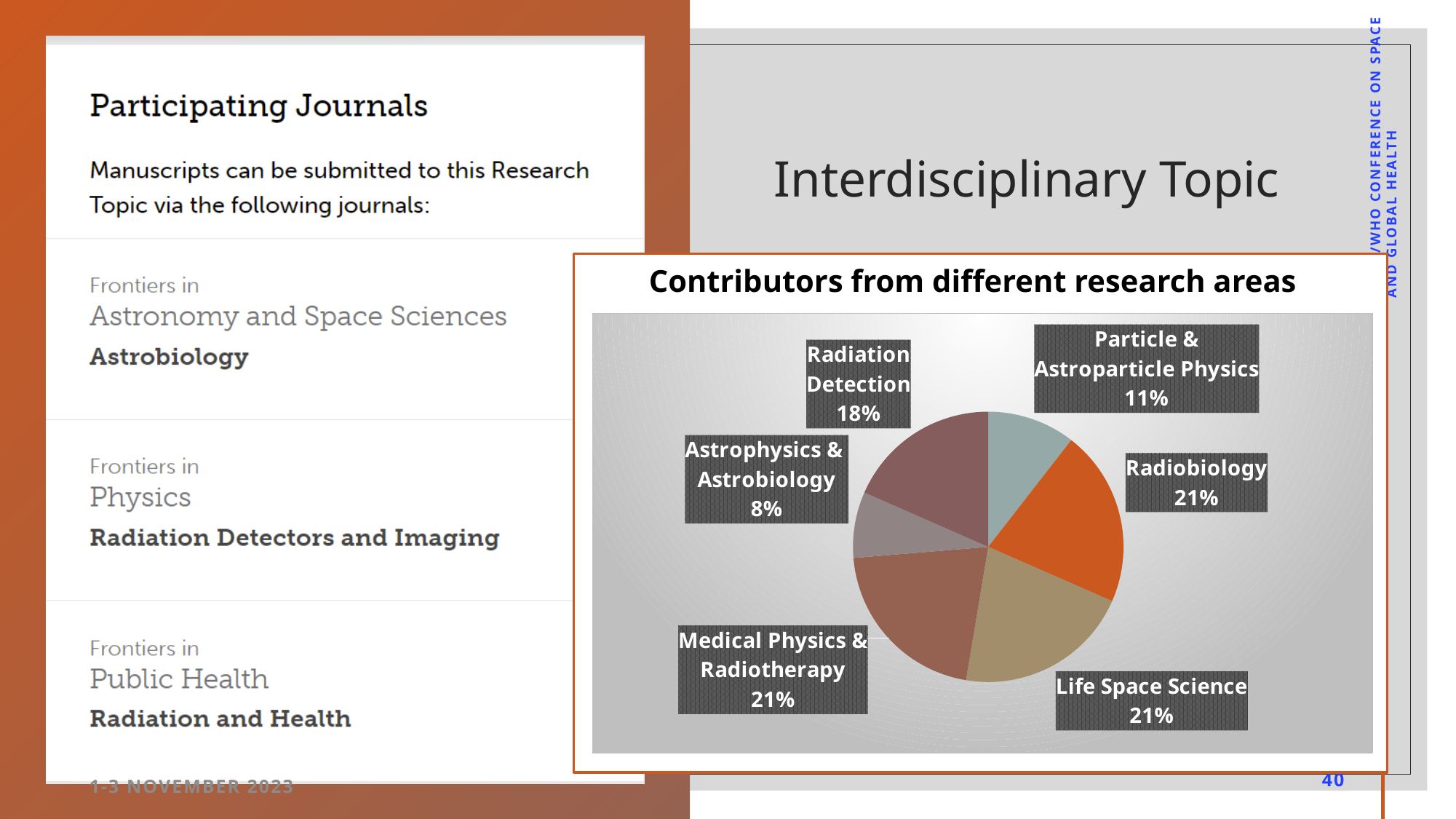
What is the difference in percentage points between the share for Medical Physics & Radiotherapy and the share for Particle & Astroparticle Physics? 10 What share of contributors comes from Astrophysics & Astrobiology? 8% What share of contributors comes from Radiation Detection? 18% What share of contributors comes from Life Space Science? 21% What is the title of the chart? Contributors from different research areas What kind of chart is shown on the slide? pie chart What share of contributors comes from Particle & Astroparticle Physics? 11% Which has a larger share of contributors, Radiation Detection or Particle & Astroparticle Physics? Radiation Detection Which research area has the smallest share of contributors? Astrophysics & Astrobiology How many research areas are shown in the pie chart? 6 What is the difference in percentage points between the share for Radiation Detection and the share for Astrophysics & Astrobiology? 10